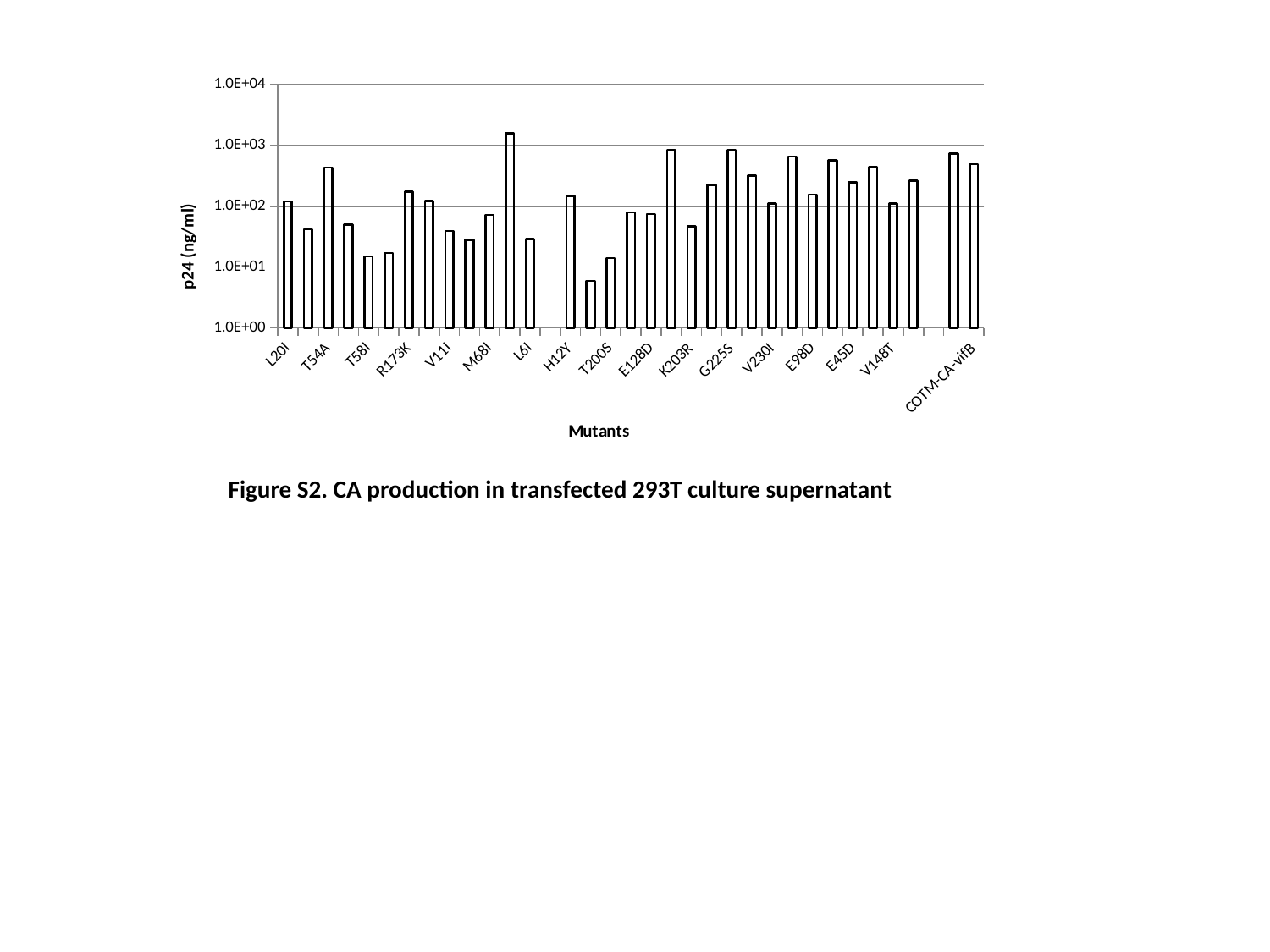
What kind of chart is shown on the slide? bar chart Is the value for V11I greater or less than 1.0E+02? less Which has the larger value, G225S or T58I? G225S Is the value for T200S greater or less than 1.0E+02? less What is the label of the y axis? p24 (ng/ml) Which has the larger value, T54A or V11I? T54A Is the value for E45D greater or less than 1.0E+02? greater What is the label of the x axis? Mutants